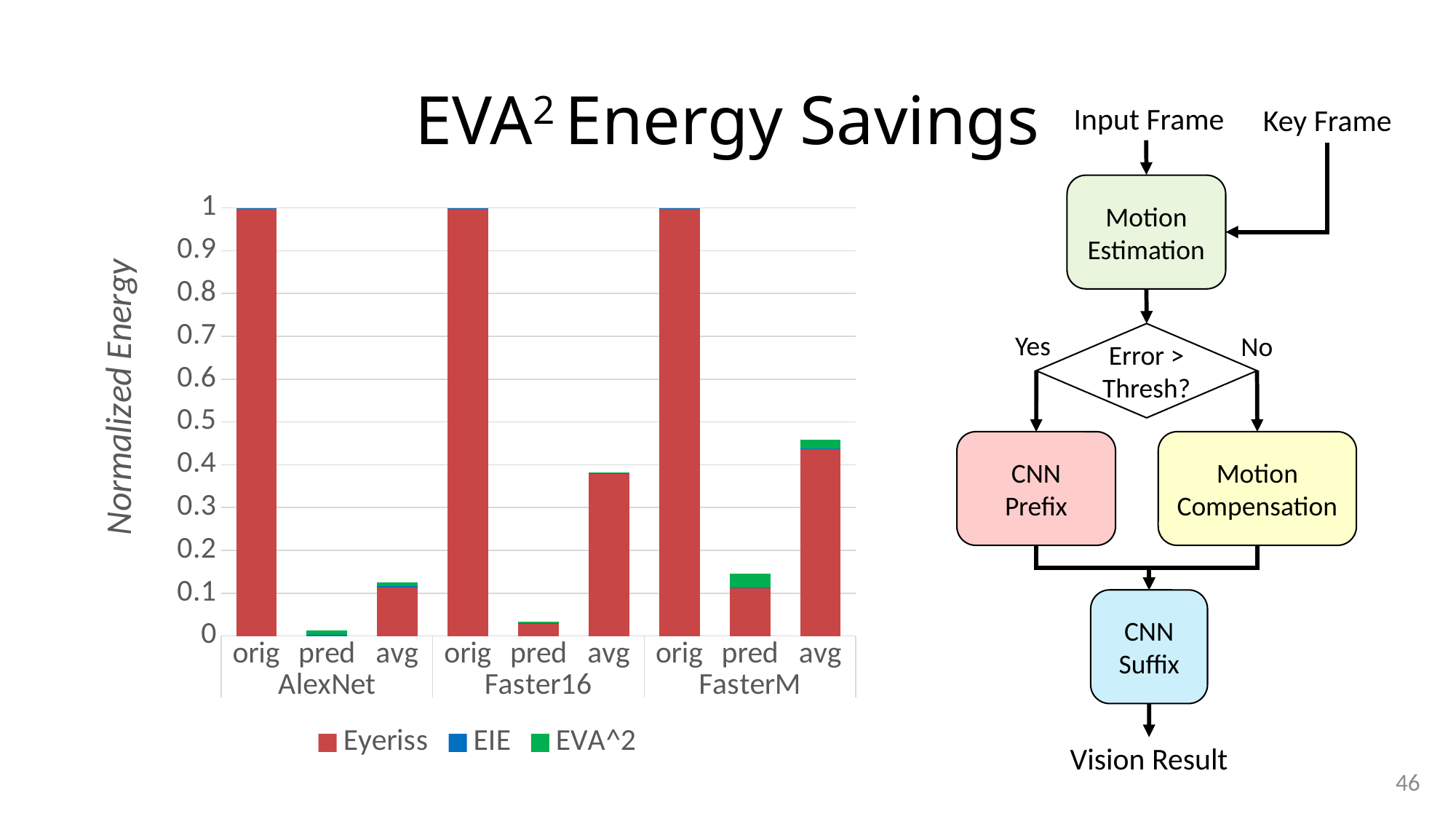
Is the value of the avg bar for FasterM greater or less than 0.4? greater How many bars are plotted in the chart? 9 What kind of chart is shown on the slide? bar chart How many series does the chart's legend list? 3 Is the value of the avg bar for AlexNet greater or less than 0.2? less Which is larger, the avg bar for Faster16 or the avg bar for FasterM? FasterM avg What is the normalized energy value of the orig bar for FasterM? 1 Is the value of the pred bar for Faster16 greater or less than 0.1? less Which bar has the lowest normalized energy in the chart? AlexNet pred What is the label of the chart's vertical axis? Normalized Energy What is the normalized energy value of the orig bar for AlexNet? 1